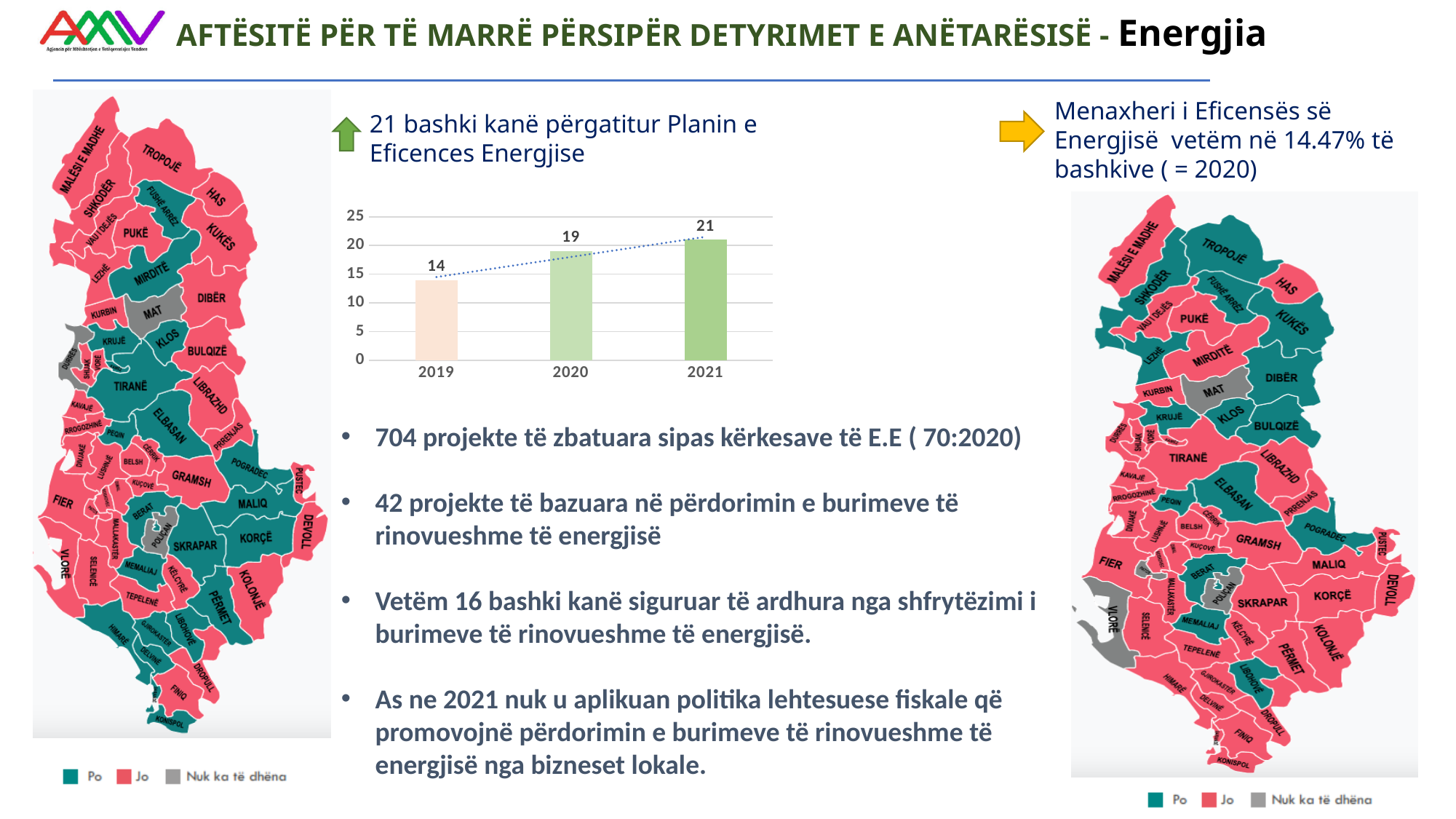
What is the value for 2021 in the bar chart? 21 What is the difference between the values for 2020 and 2019 in the bar chart? 5 What kind of chart is shown in the middle of the slide? bar chart What is the difference between the values for 2021 and 2019 in the bar chart? 7 What is the value for 2019 in the bar chart? 14 Which year has the lowest value in the bar chart? 2019 Do the values in the bar chart rise or fall from 2019 to 2021? rise Is the value for 2019 in the bar chart greater or less than 15? less How many years are shown on the x axis of the bar chart? 3 Which is larger in the bar chart, the value for 2020 or the value for 2021? 2021 Which year has the highest value in the bar chart? 2021 What is the value for 2020 in the bar chart? 19